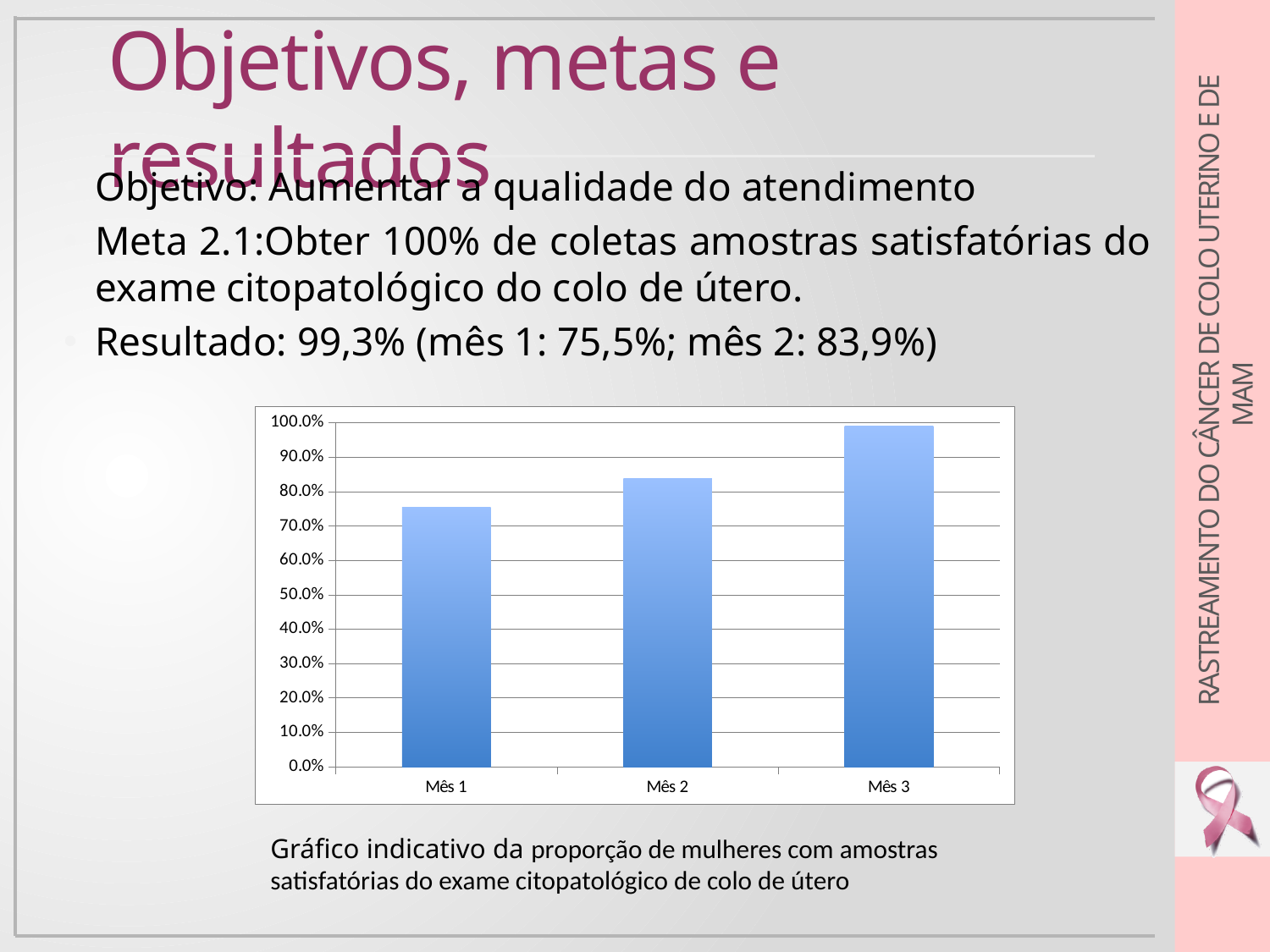
Do the values rise or fall from Mês 1 to Mês 3? rise What is the maximum value shown on the chart's y axis? 100.0% Which month has the highest bar in the chart? Mês 3 Is the bar for Mês 3 greater or less than 90.0%? greater How many categories are shown on the x axis of the chart? 3 Which month has the lowest bar in the chart? Mês 1 Is the bar for Mês 1 greater or less than 80.0%? less Is the bar for Mês 1 greater or less than 70.0%? greater What kind of chart is shown on the slide? bar chart What is the label of the first category on the x axis? Mês 1 Which is larger, the bar for Mês 2 or the bar for Mês 3? Mês 3